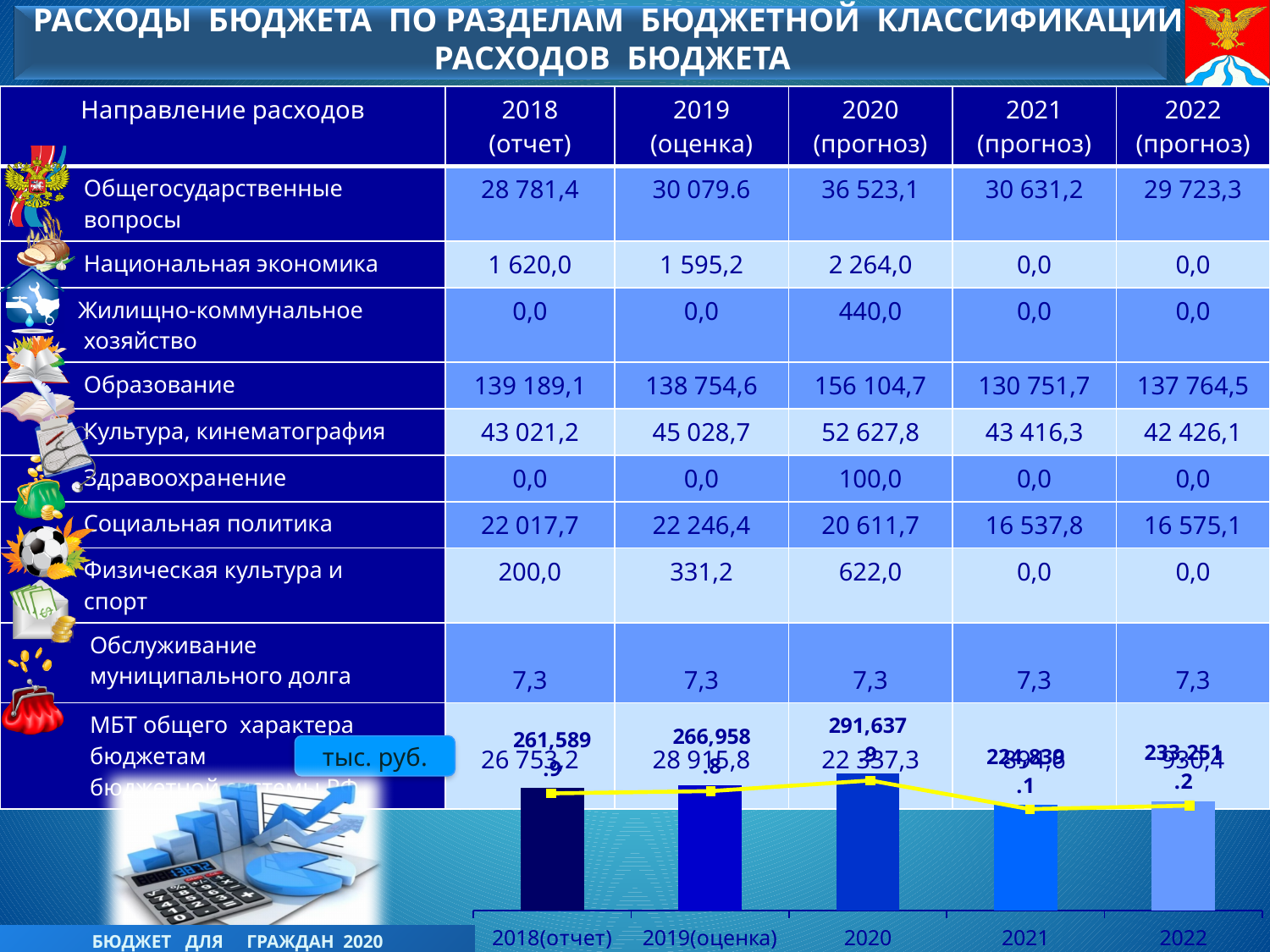
On the bar chart at the bottom of the slide, what is the difference between the 2019(оценка) value and the 2018(отчет) value? 5,368.9 On the bar chart at the bottom of the slide, what is the value for 2018(отчет)? 261,589.9 What kind of chart is shown at the bottom of the slide? Bar chart with a line overlay On the bar chart at the bottom of the slide, do the values rise or fall from 2018(отчет) to 2020? Rise How many years (categories) are plotted on the bar chart at the bottom of the slide? 5 On the bar chart at the bottom of the slide, which year has the highest value? 2020 On the bar chart at the bottom of the slide, which is larger: the value for 2020 or for 2021? 2020 What unit is indicated for the values on the bar chart at the bottom of the slide? тыс. руб. On the bar chart at the bottom of the slide, what is the value for 2020? 291,637.9 On the bar chart at the bottom of the slide, what is the difference between the 2020 value and the 2018(отчет) value? 30,048.0 On the bar chart at the bottom of the slide, what is the value for 2019(оценка)? 266,958.8 On the bar chart at the bottom of the slide, which is larger: the value for 2018(отчет) or for 2019(оценка)? 2019(оценка)